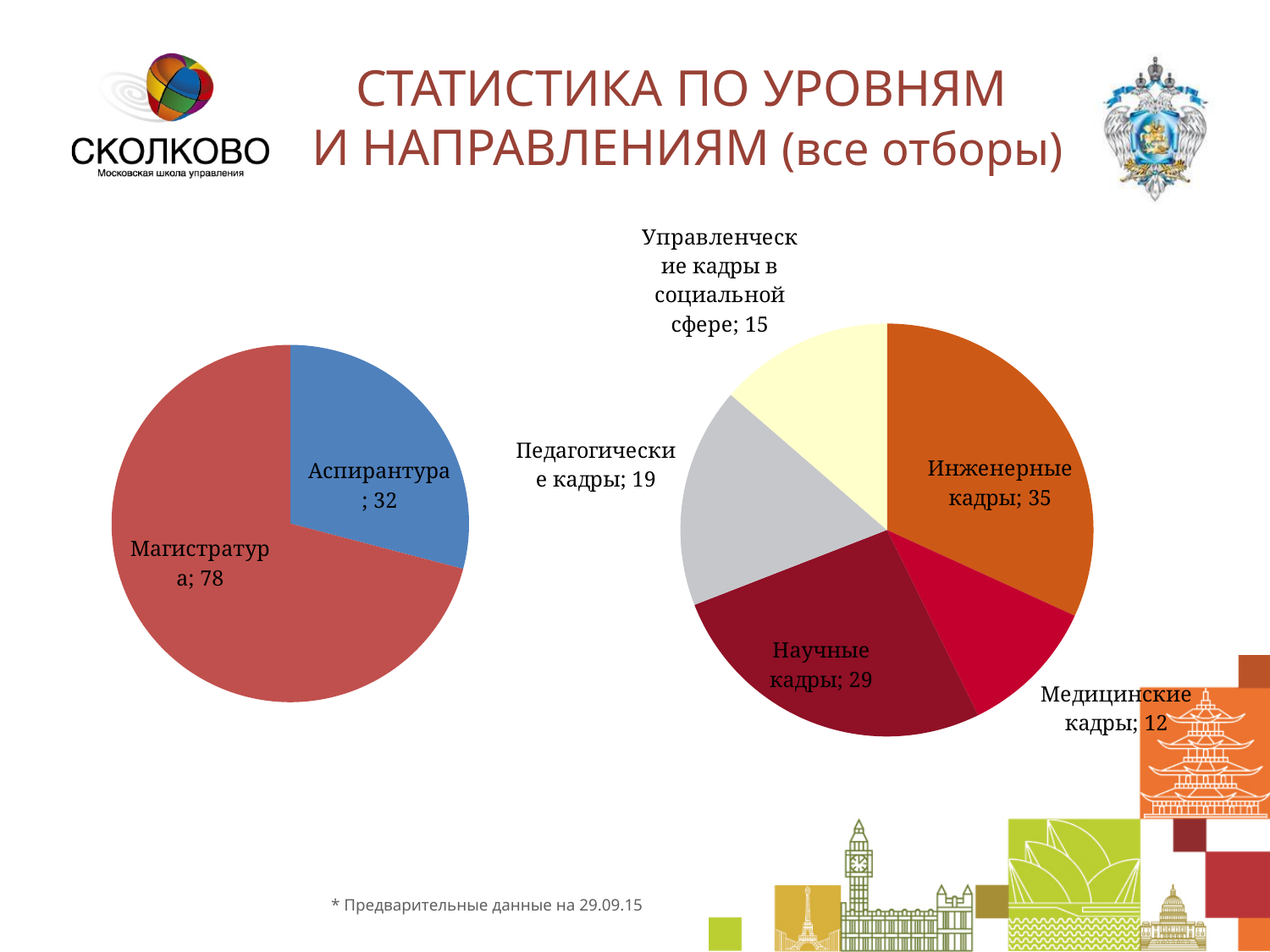
In the left pie chart, what is the difference between Магистратура and Аспирантура? 46 In the right pie chart, what is the value for Медицинские кадры? 12 In the right pie chart, what is the value for Управленческие кадры в социальной сфере? 15 What kind of charts are shown on the slide? Pie charts In the right pie chart, what is the value for Инженерные кадры? 35 In the right pie chart, which category has the smallest value? Медицинские кадры In the right pie chart, what is the total of all slices? 110 In the left pie chart, how many slices are there? 2 In the right pie chart, which is larger: Научные кадры or Педагогические кадры? Научные кадры In the right pie chart, which category has the largest value? Инженерные кадры In the left pie chart, what is the value for Аспирантура? 32 In the left pie chart, what is the value for Магистратура? 78